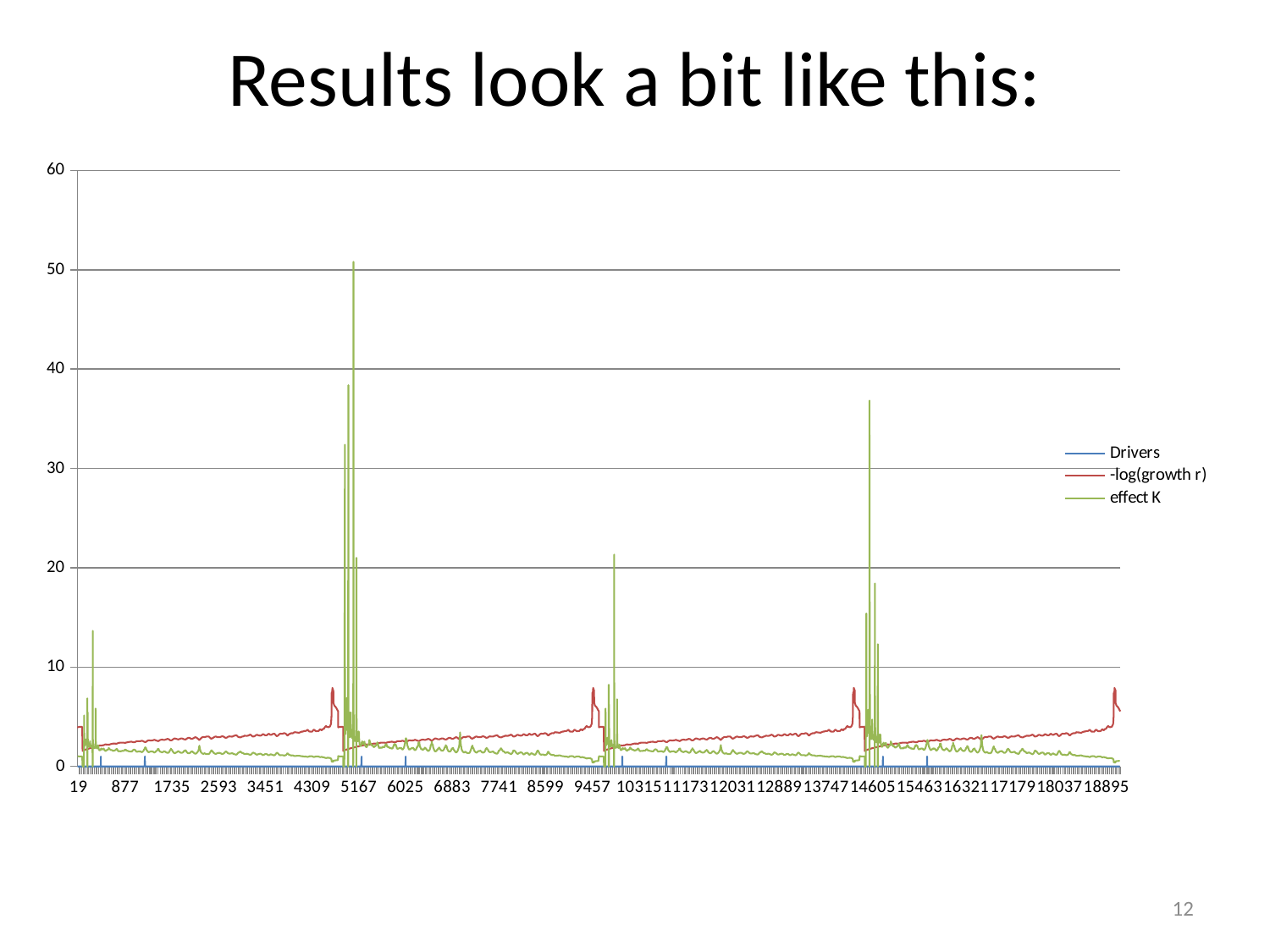
Which series stays closest to zero across the whole chart? Drivers Is the highest value of the -log(growth r) series greater or less than 10? less What are the three series named in the legend? Drivers, -log(growth r), effect K How many series does the legend list? 3 Which series reaches the highest value anywhere on the chart? effect K What is the first label on the horizontal axis? 19 What is the last label on the horizontal axis? 18895 What is the highest value shown on the vertical axis? 60 Is the Drivers series ever greater or less than 10? less What is the title of the slide above the chart? Results look a bit like this: Is the highest peak of the effect K series greater or less than 40? greater What kind of chart is shown on the slide? line chart